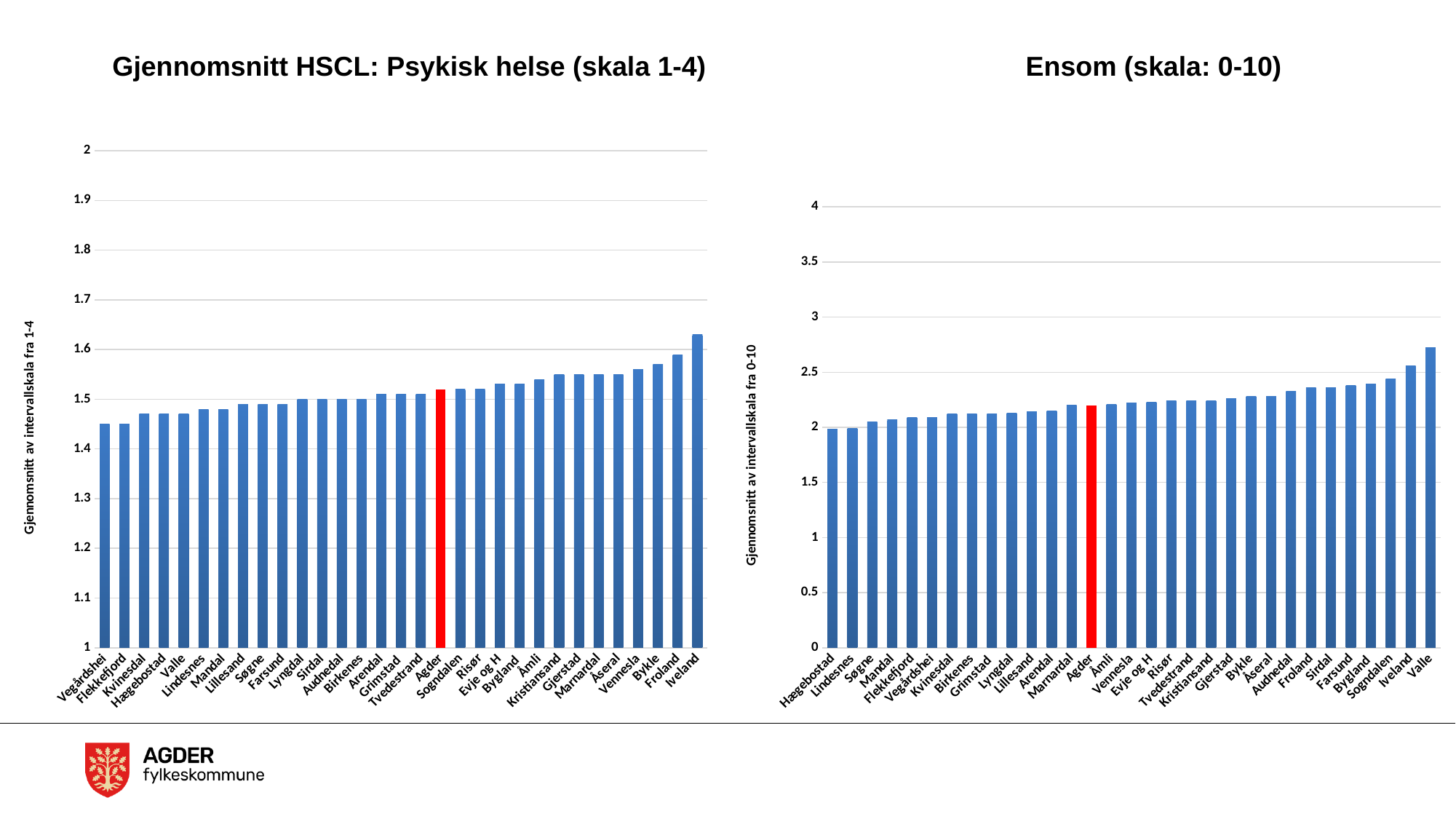
On the right chart (Ensom), which is larger, the value for Hægebostad or the value for Valle? Valle On the right chart (Ensom), is the value for Valle greater or less than 3? less On the right chart (Ensom), which category is shown with a red bar? Agder What kind of chart is the right chart (Ensom)? Bar chart On the left chart (Gjennomsnitt HSCL: Psykisk helse), is the value for Iveland greater or less than 1.6? greater How many municipalities/categories are shown on the left chart (Gjennomsnitt HSCL: Psykisk helse)? 31 On the left chart (Gjennomsnitt HSCL: Psykisk helse), which is larger, the value for Iveland or the value for Vegårdshei? Iveland On the right chart (Ensom), is the value for Valle greater or less than 2.5? greater On the right chart (Ensom), which municipality has the highest value? Valle On the left chart (Gjennomsnitt HSCL: Psykisk helse), which municipality has the highest value? Iveland